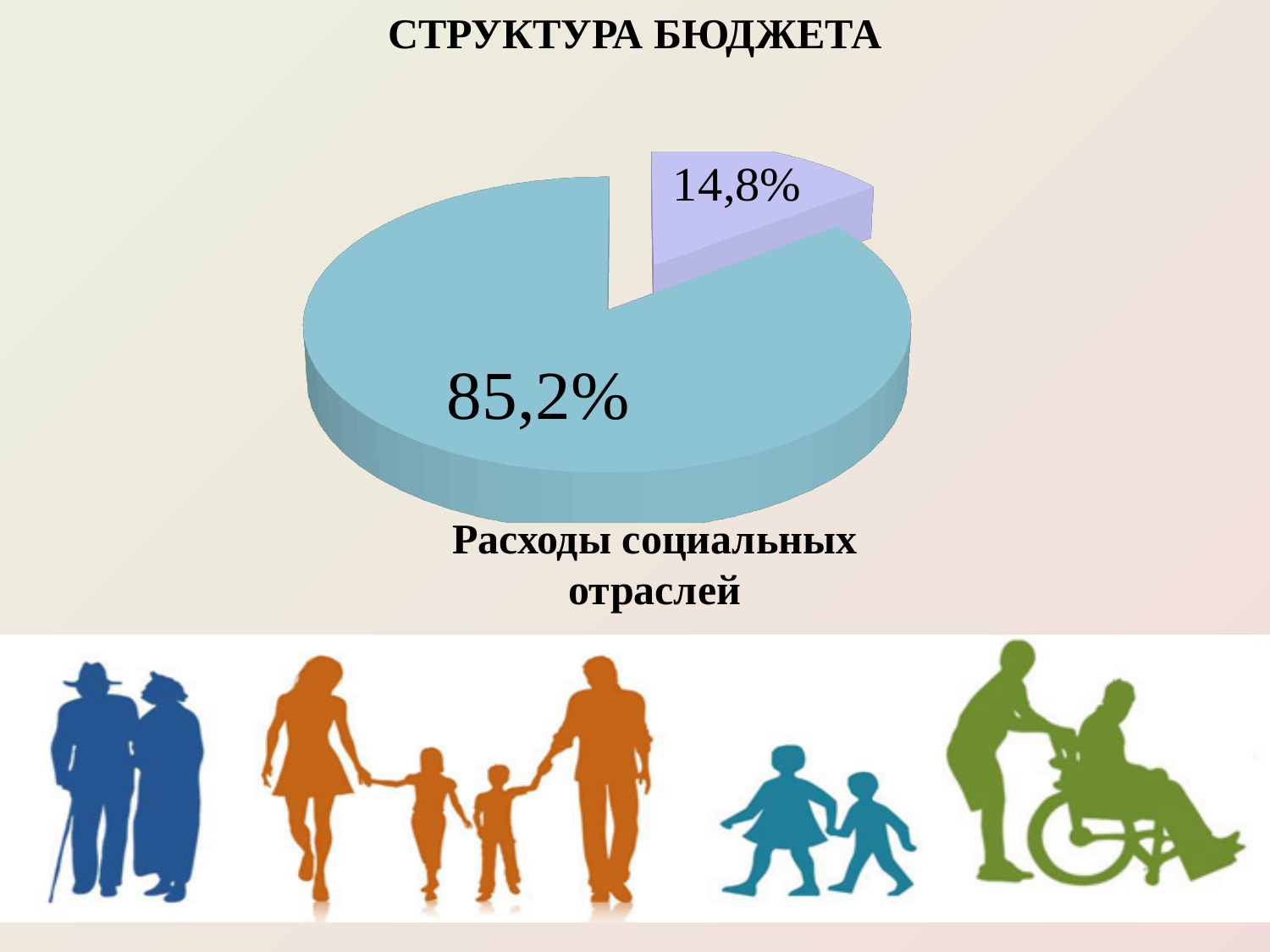
What colour is the slice labelled 85,2%? blue What percentage is shown on the smaller, exploded slice of the pie? 14,8% What is the title of the chart? СТРУКТУРА БЮДЖЕТА Is the share for "Расходы социальных отраслей" greater or less than 50%? greater What is the difference in percentage points between the two slices of the pie? 70,4 What kind of chart is shown on the slide? pie chart Which slice of the pie is the largest? 85,2% What is the value of the smallest slice in the pie chart? 14,8% What share of the pie is labelled "Расходы социальных отраслей"? 85,2% How many slices does the pie chart have? 2 Which is larger: the slice labelled 85,2% or the slice labelled 14,8%? 85,2%